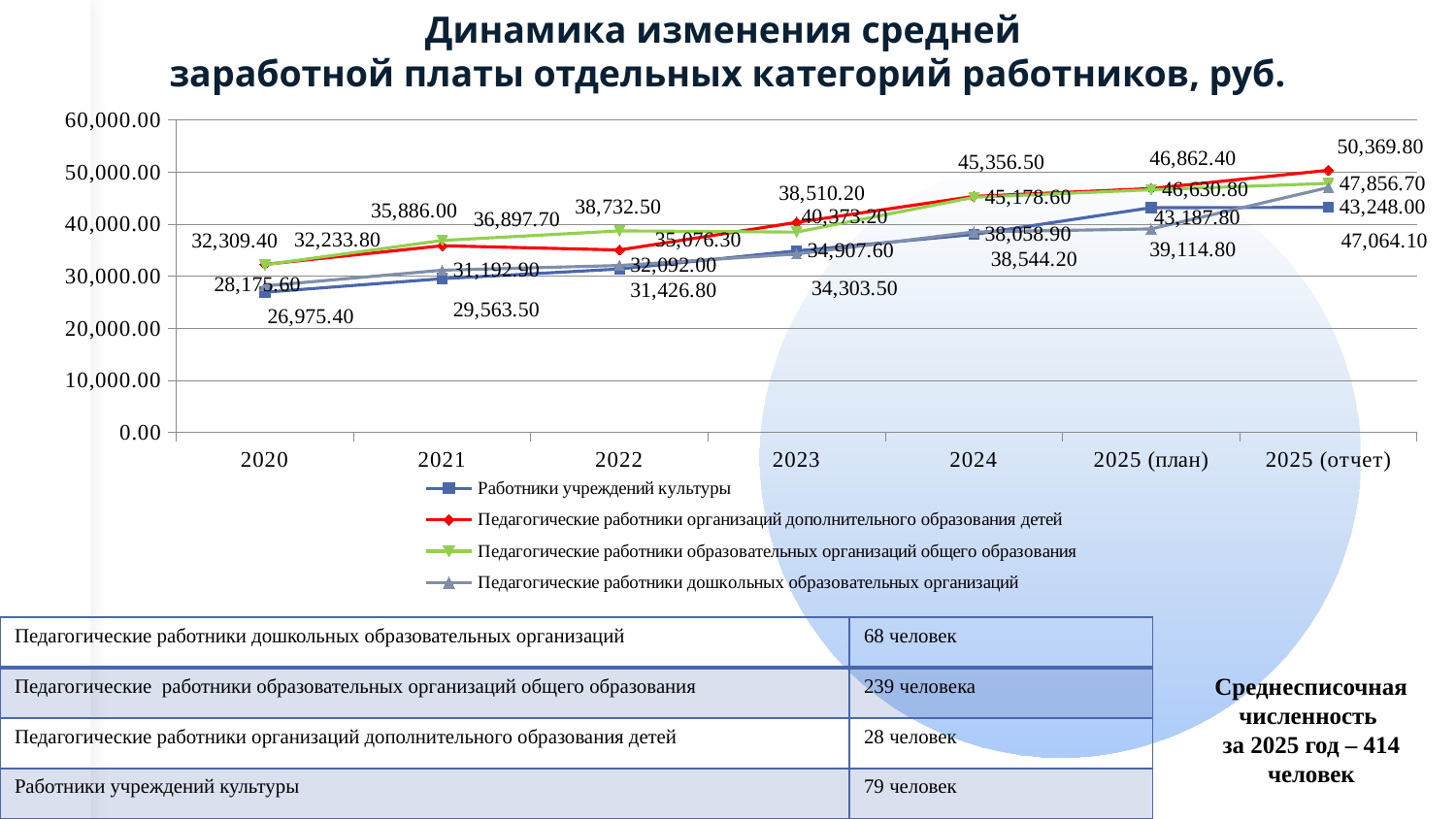
Is the value for Работники учреждений культуры in 2020 greater or less than 30,000.00? less How many series does the legend list? 4 Which series has the lowest value in 2020? Работники учреждений культуры What is the value for Педагогические работники организаций дополнительного образования детей in 2025 (отчет)? 50,369.80 Which series has the highest value in 2025 (отчет)? Педагогические работники организаций дополнительного образования детей What is the value for Работники учреждений культуры in 2025 (план)? 43,187.80 Does the value for Работники учреждений культуры rise or fall from 2020 to 2025 (отчет)? rise What is the value for Педагогические работники образовательных организаций общего образования in 2025 (отчет)? 47,856.70 What is the value for Педагогические работники дошкольных образовательных организаций in 2025 (план)? 39,114.80 What is the difference between the 2025 (отчет) values for Педагогические работники организаций дополнительного образования детей and Работники учреждений культуры? 7,121.80 What kind of chart is shown on the slide? line chart How many points along the x axis does the chart have? 7